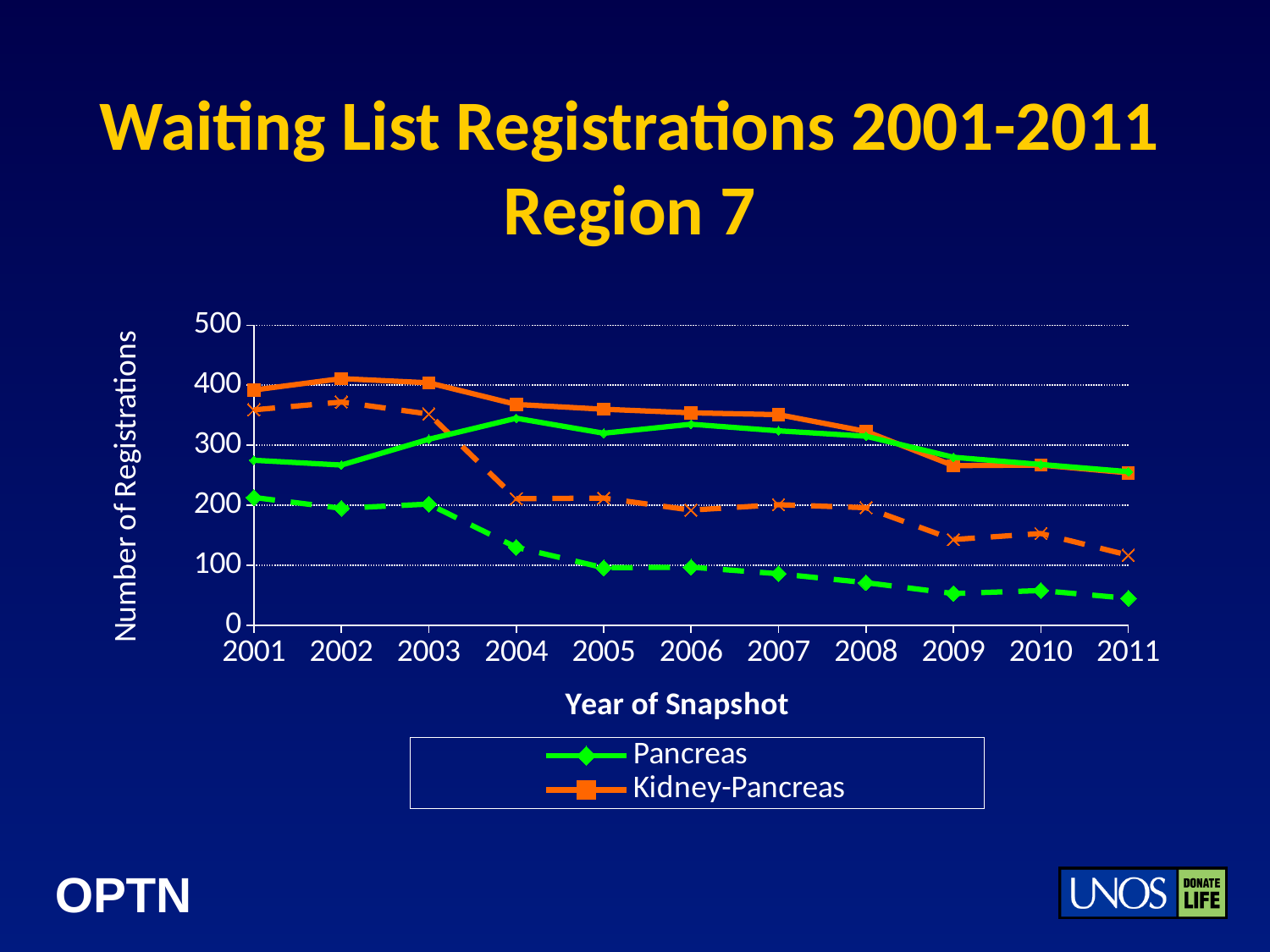
Does the dashed Pancreas line rise or fall from 2001 to 2011? Fall What is the label of the y axis? Number of Registrations How many years are plotted along the x axis? 11 Is the value of the solid Pancreas line in 2001 greater or less than 300? less Is the value of the dashed Pancreas line in 2011 greater or less than 100? less Is the value of the dashed Kidney-Pancreas line in 2001 greater or less than 300? greater What is the title of the chart on the slide? Waiting List Registrations 2001-2011 Region 7 What kind of chart is shown on the slide? Line chart In 2001, which solid line is higher: Pancreas or Kidney-Pancreas? Kidney-Pancreas How many series does the legend list? 2